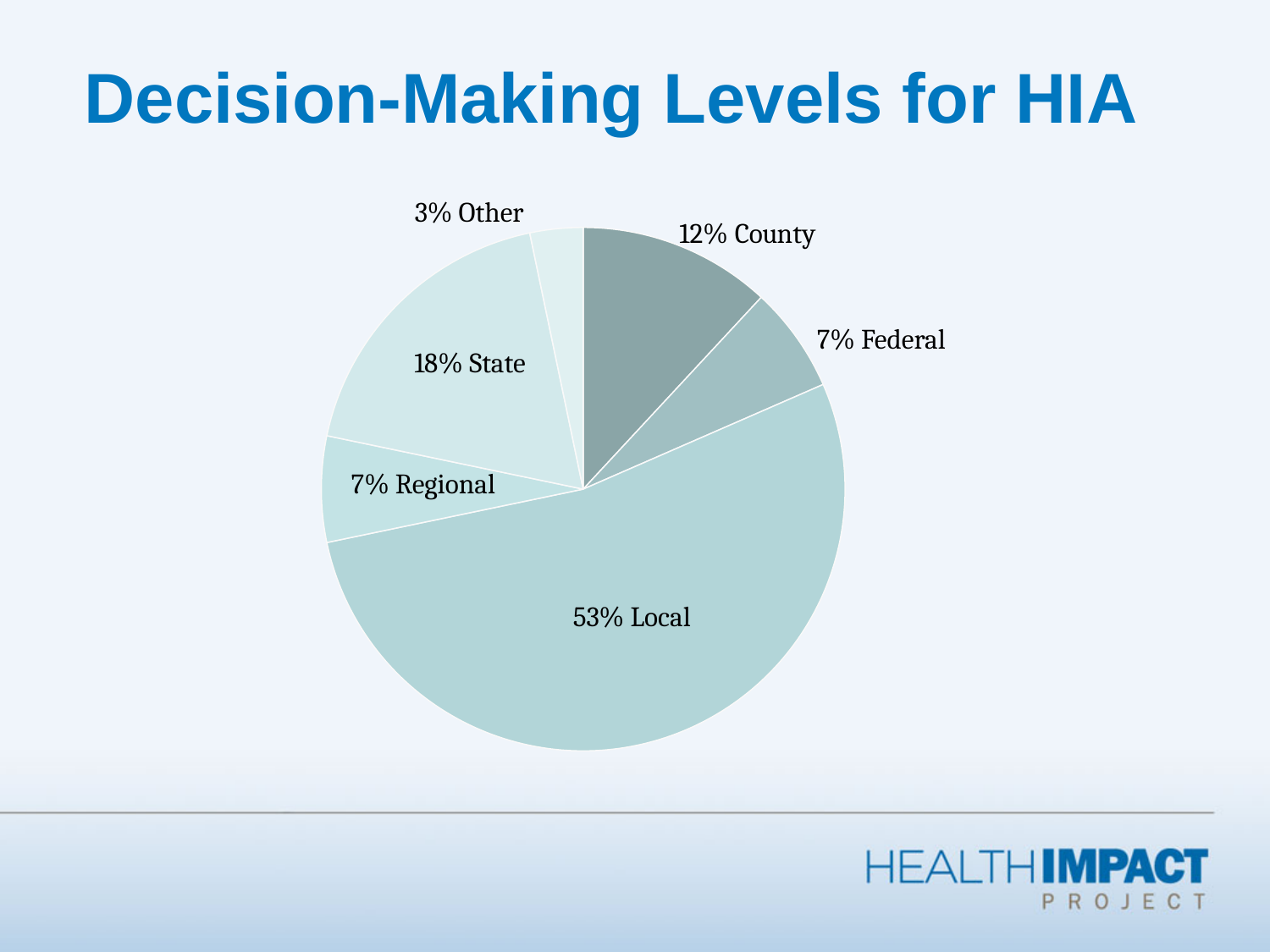
Which category has the largest slice of the pie? Local What share of the pie is Other? 3% What is the combined share of the Federal and Regional slices? 14% What share of the pie is Local? 53% What is the difference in percentage points between the State and County slices? 6 How many slices does the pie chart have? 6 Which is larger, the County slice or the Federal slice? County What kind of chart is shown on the slide? Pie chart Which category has the smallest slice of the pie? Other What is the title of the slide containing the chart? Decision-Making Levels for HIA What share of the pie is State? 18%